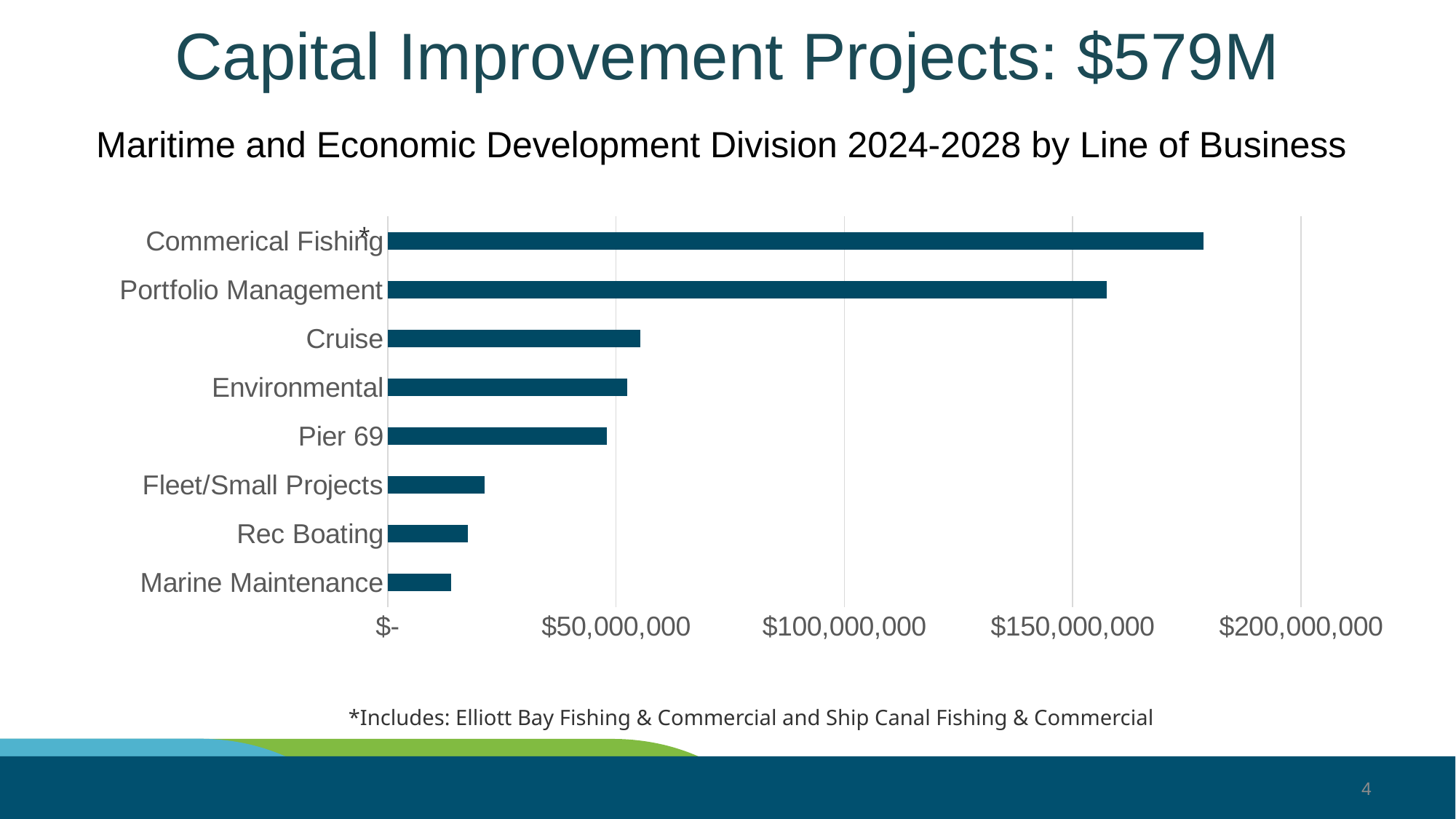
Is the value for Pier 69 greater or less than $50,000,000? less Is the value for Fleet/Small Projects greater or less than $50,000,000? less How many lines of business are plotted in the chart? 8 Is the value for Cruise greater or less than $50,000,000? greater What total amount of capital improvement projects is stated in the slide title? $579M What kind of chart is shown on the slide? bar chart Which line of business has the lowest capital improvement project value? Marine Maintenance Which is larger, the value for Cruise or the value for Rec Boating? Cruise Which is larger, the value for Commerical Fishing or the value for Portfolio Management? Commerical Fishing Which line of business has the highest capital improvement project value? Commerical Fishing